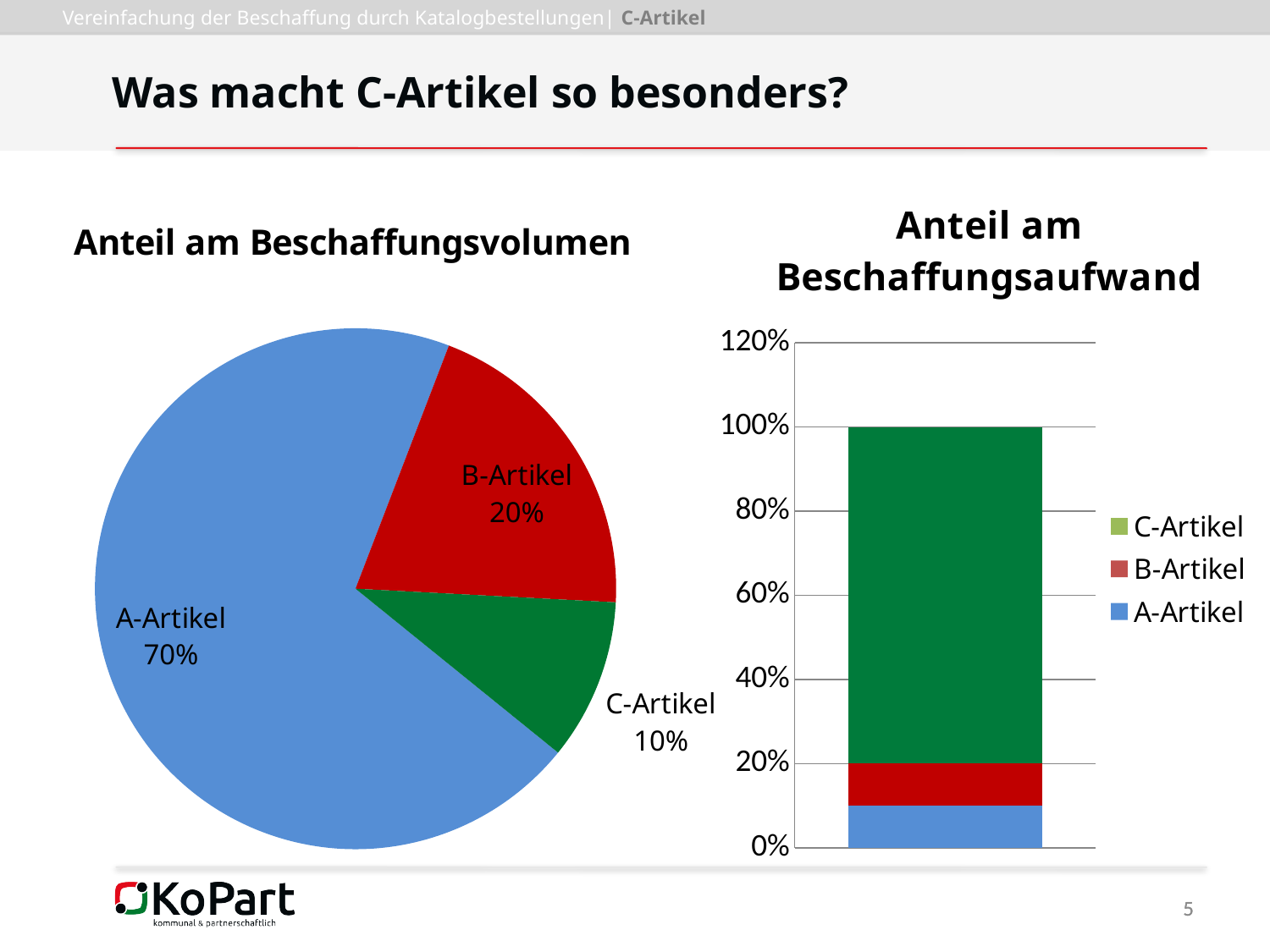
In the chart 'Anteil am Beschaffungsaufwand', is the value for C-Artikel greater or less than 60%? greater In the chart 'Anteil am Beschaffungsaufwand', is the value for A-Artikel greater or less than 20%? less In the pie chart 'Anteil am Beschaffungsvolumen', what share do C-Artikel have? 10% What kind of chart is the chart on the right, 'Anteil am Beschaffungsaufwand'? Stacked bar chart In the pie chart 'Anteil am Beschaffungsvolumen', which category has the largest share? A-Artikel How many slices does the pie chart 'Anteil am Beschaffungsvolumen' have? 3 In the pie chart 'Anteil am Beschaffungsvolumen', which is larger, the share of B-Artikel or the share of C-Artikel? B-Artikel How many series does the legend of the chart 'Anteil am Beschaffungsaufwand' list? 3 In the pie chart 'Anteil am Beschaffungsvolumen', which category has the smallest share? C-Artikel In the pie chart 'Anteil am Beschaffungsvolumen', what is the difference between the shares of A-Artikel and B-Artikel? 50% In the pie chart 'Anteil am Beschaffungsvolumen', what share do A-Artikel have? 70% What kind of chart is the chart on the left, 'Anteil am Beschaffungsvolumen'? Pie chart